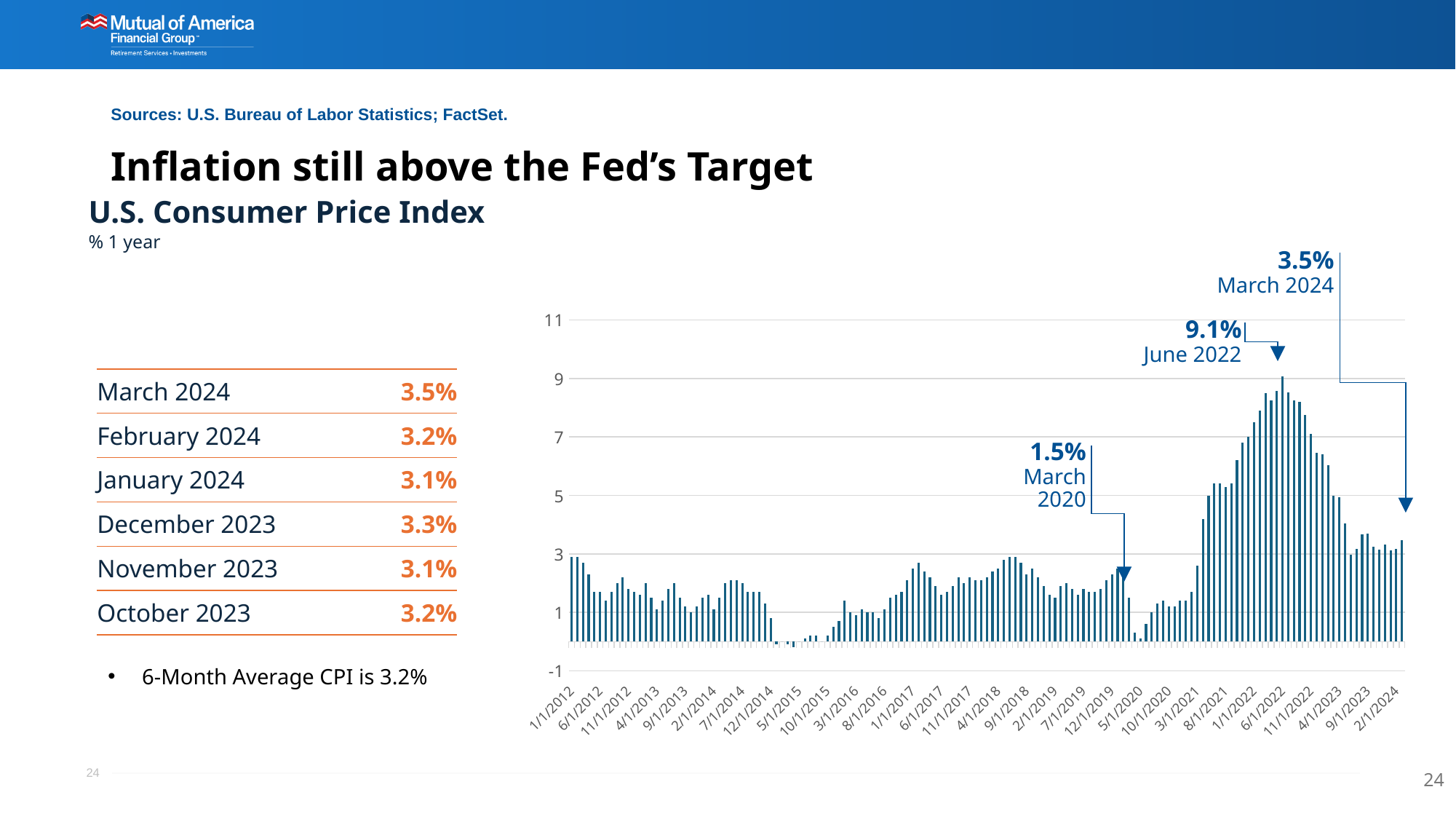
What is the annotated CPI value for March 2024? 3.5% Which annotated month shows the highest CPI value on the chart? June 2022 What is the annotated CPI value for June 2022? 9.1% Is the CPI value around 5/1/2015 greater or less than 1? less What kind of chart is used to show the U.S. Consumer Price Index? Bar chart By how many percentage points is the June 2022 CPI value higher than the March 2024 value? 5.6 percentage points Which annotated month shows the lowest CPI value on the chart? March 2020 Is the CPI value at 1/1/2022 greater or less than 5? greater What is the highest tick value shown on the chart's vertical axis? 11 Which is larger, the CPI value for March 2020 or for March 2024? March 2024 What is the annotated CPI value for March 2020? 1.5% Do the CPI values rise or fall from June 2022 to March 2024? Fall